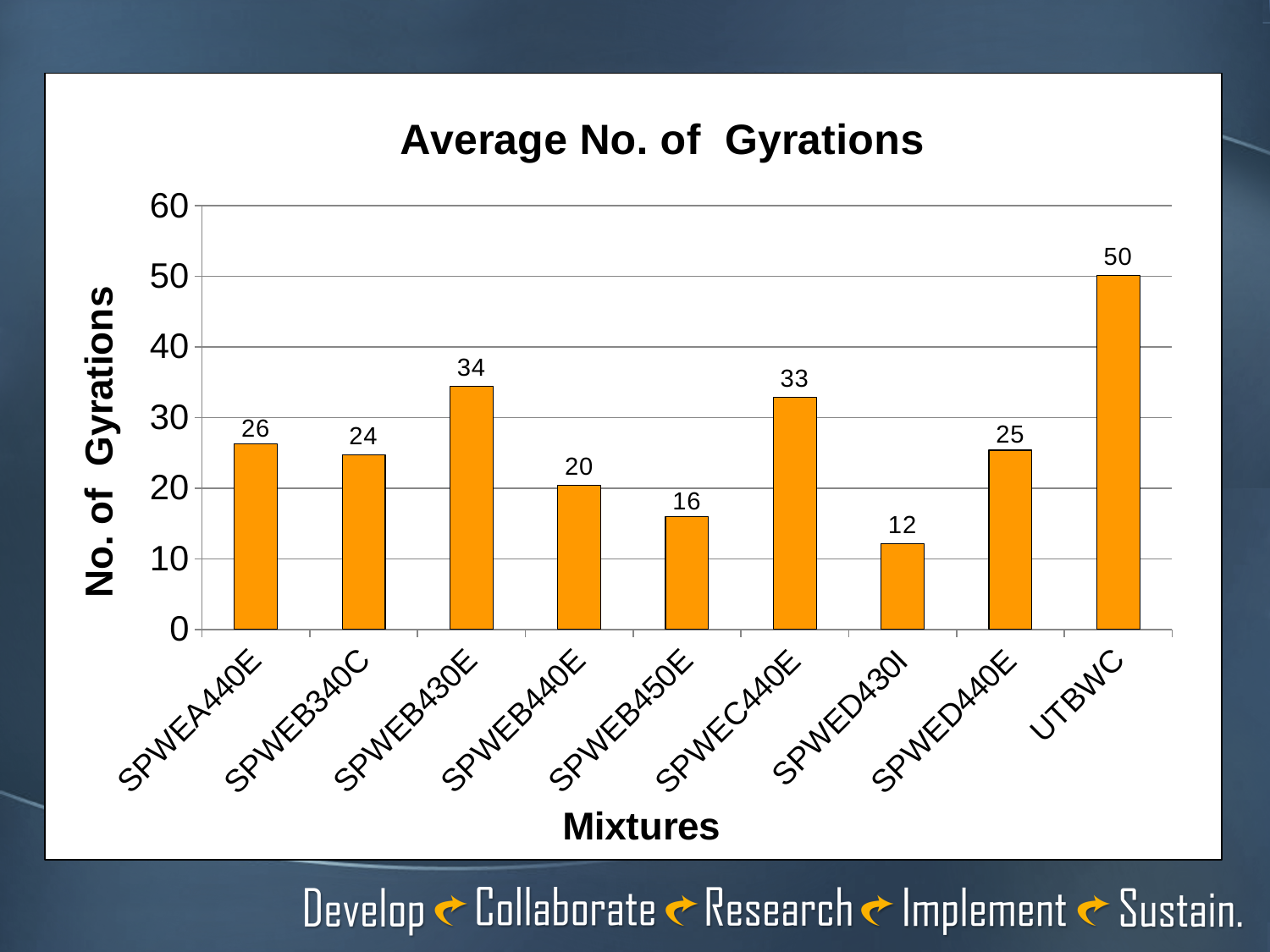
Which mixture has the highest average number of gyrations? UTBWC What is the average number of gyrations for SPWED430I? 12 How many mixtures are shown on the chart? 9 What is the average number of gyrations for SPWEB430E? 34 What is the label of the x axis? Mixtures What is the difference in average number of gyrations between UTBWC and SPWEB430E? 16 What is the title of the chart? Average No. of Gyrations Which mixture has the lowest average number of gyrations? SPWED430I Which has a higher average number of gyrations, SPWEC440E or SPWEB440E? SPWEC440E What is the average number of gyrations for UTBWC? 50 Is the value for SPWEB450E greater or less than 20? less What kind of chart is shown on the slide? Bar chart